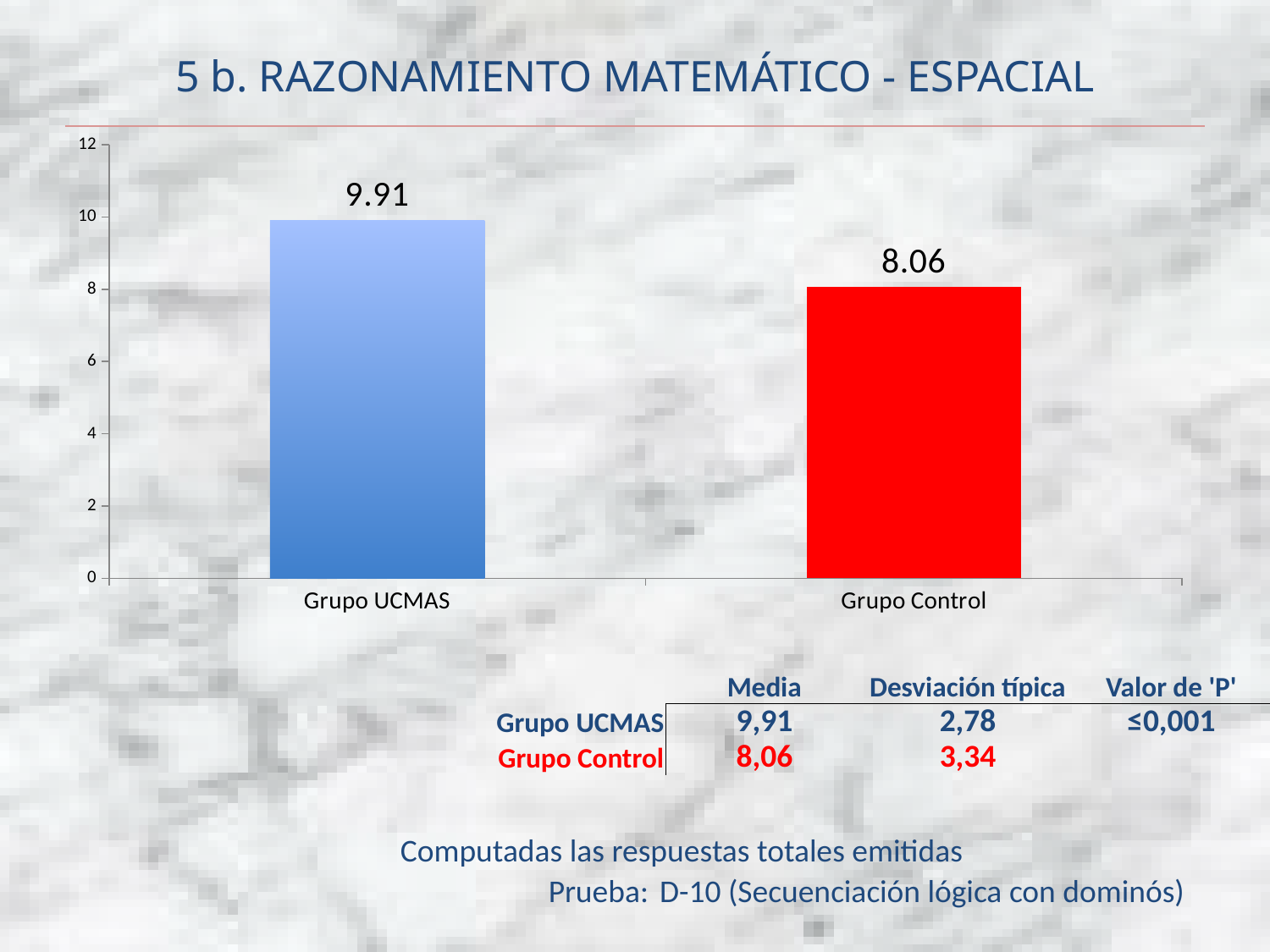
What colour is the bar for Grupo Control? red Is the value for Grupo Control larger or smaller than the value for Grupo UCMAS? smaller How many categories are shown in the chart? 2 Which group has the lower value? Grupo Control What is the value for Grupo UCMAS? 9.91 What kind of chart is shown on the slide? bar chart What is the value for Grupo Control? 8.06 Which group has the higher value? Grupo UCMAS Is the value for Grupo UCMAS greater or less than 8? greater What is the maximum value shown on the vertical axis? 12 What is the difference between the values for Grupo UCMAS and Grupo Control? 1.85 Is the value for Grupo Control greater or less than 10? less